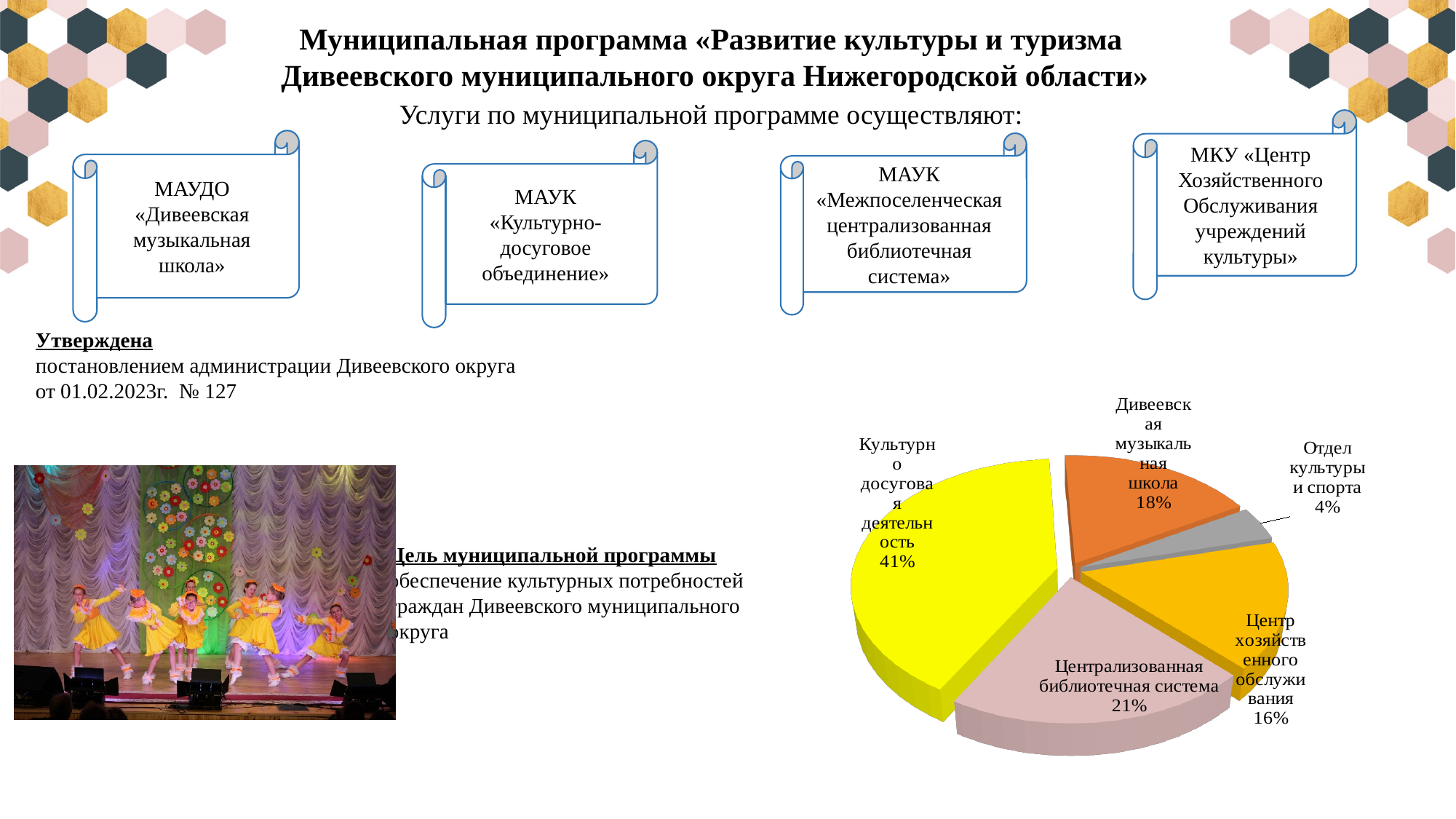
Which slice of the pie chart is the largest? Культурно досуговая деятельность Which is larger: the share for "Дивеевская музыкальная школа" or for "Центр хозяйственного обслуживания"? Дивеевская музыкальная школа What colour is the slice for "Культурно досуговая деятельность"? Yellow What share of the pie does "Дивеевская музыкальная школа" have? 18% What is the difference in percentage points between "Культурно досуговая деятельность" and "Централизованная библиотечная система"? 20 How many slices does the pie chart have? 5 What share of the pie does "Культурно досуговая деятельность" have? 41% Which slice of the pie chart is the smallest? Отдел культуры и спорта What share of the pie does "Централизованная библиотечная система" have? 21% What kind of chart is shown on the slide? Pie chart